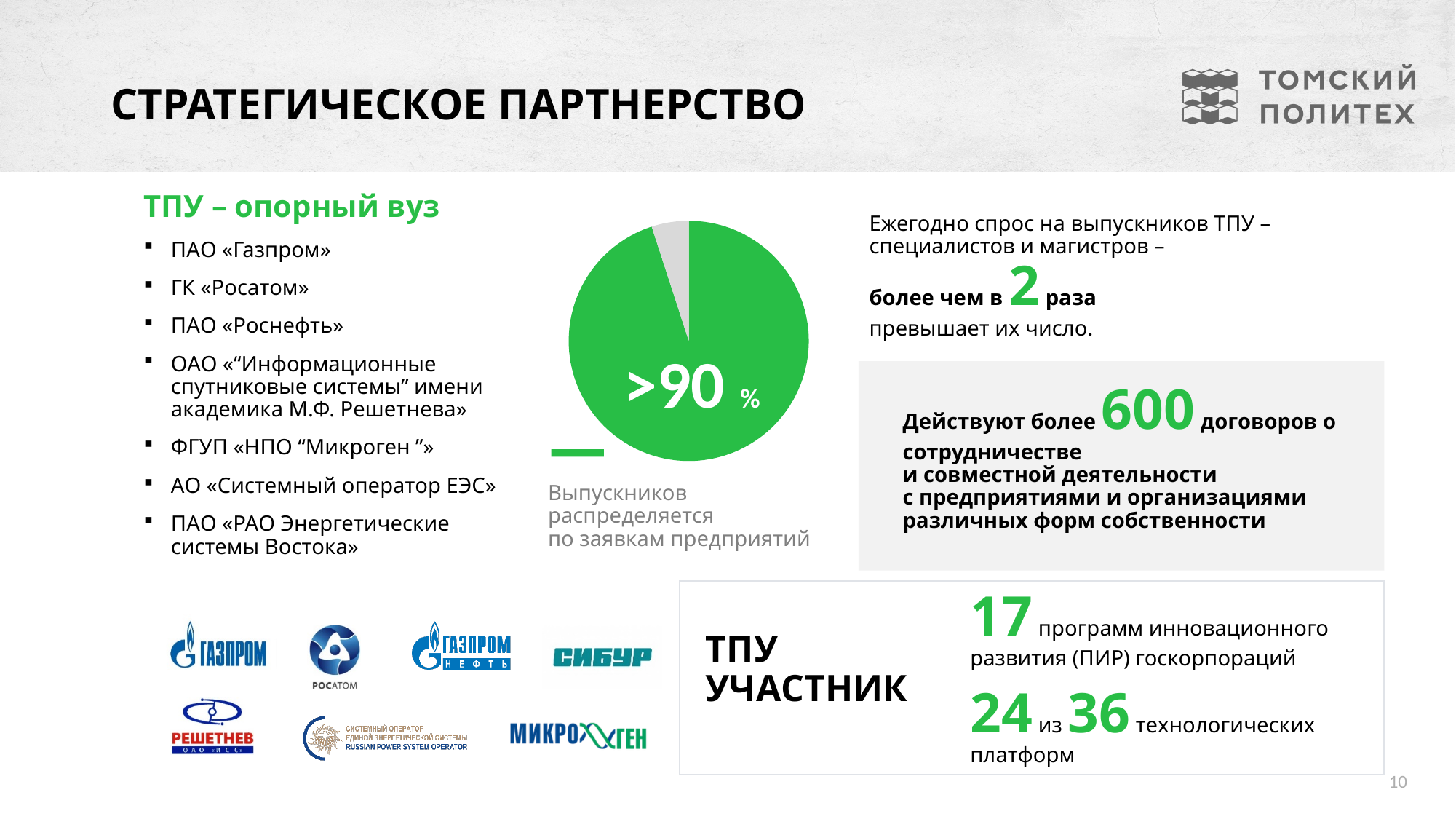
What value is printed on the pie chart? >90 % Is the green slice of the pie chart greater or less than 50%? greater What kind of chart is shown on the slide? pie chart What share of graduates is placed according to enterprise requests, as printed on the pie chart? >90 % What does the green slice of the pie chart represent, according to the legend text below it? Выпускников распределяется по заявкам предприятий Which slice of the pie chart is larger, the green one or the grey one? the green one Which slice of the pie chart is the smallest? the grey slice What colour is the slice of the pie chart labelled >90 %? green Is the grey slice of the pie chart greater or less than 25%? less How many slices does the pie chart have? 2